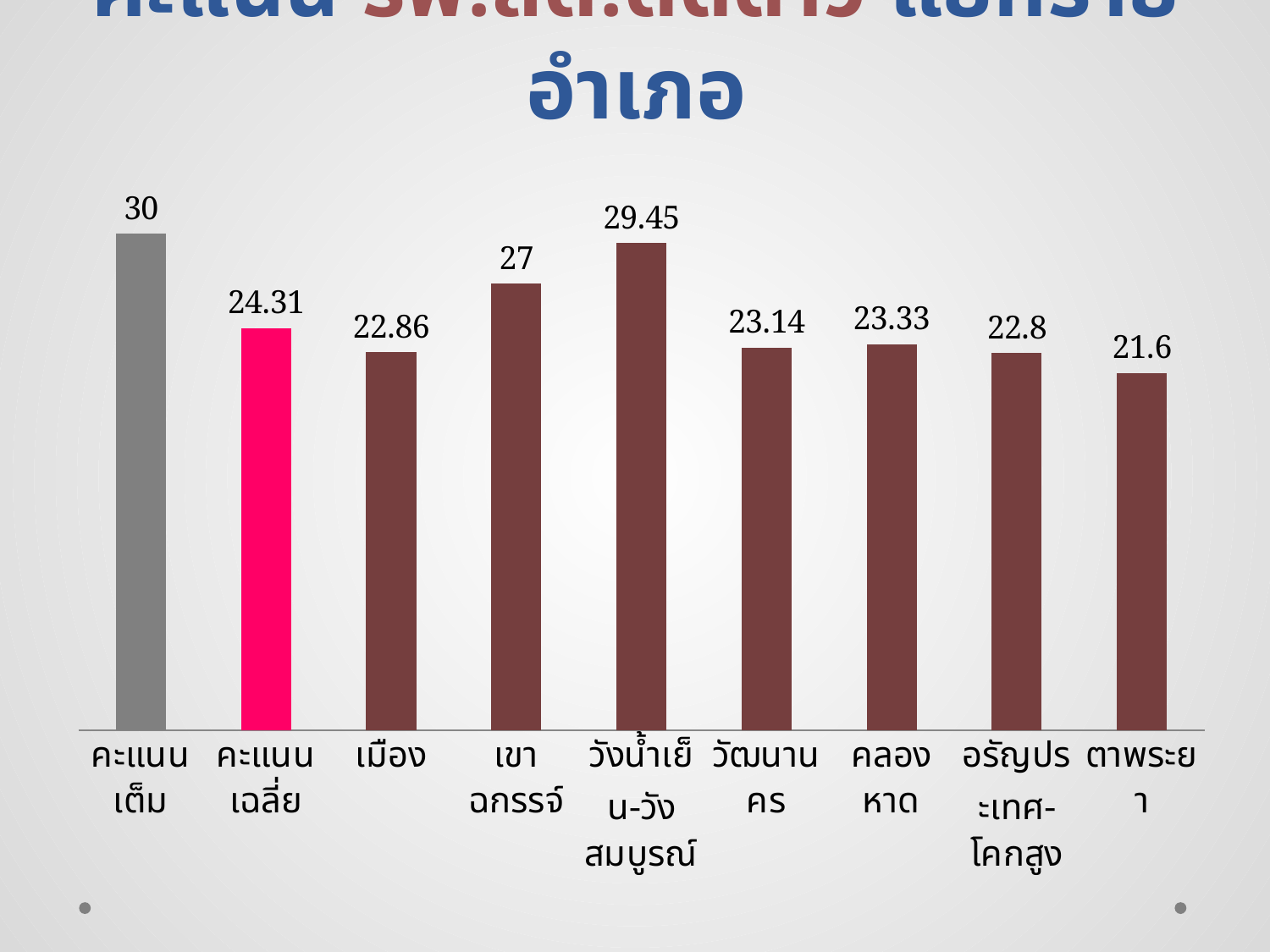
What is the difference between the values for คะแนนเต็ม and คะแนนเฉลี่ย? 5.69 What is the value for วังน้ำเย็น-วังสมบูรณ์? 29.45 What colour is the bar for คะแนนเฉลี่ย? pink How many bars are shown in the chart? 9 What is the difference between the values for เขาฉกรรจ์ and ตาพระยา? 5.4 What is the value for ตาพระยา? 21.6 Which district (excluding คะแนนเต็ม and คะแนนเฉลี่ย) has the highest value? วังน้ำเย็น-วังสมบูรณ์ What is the value for คะแนนเฉลี่ย? 24.31 Which category has the lowest value? ตาพระยา What kind of chart is shown on the slide? bar chart Which is larger, the value for คลองหาด or the value for วัฒนานคร? คลองหาด What is the value for เมือง? 22.86